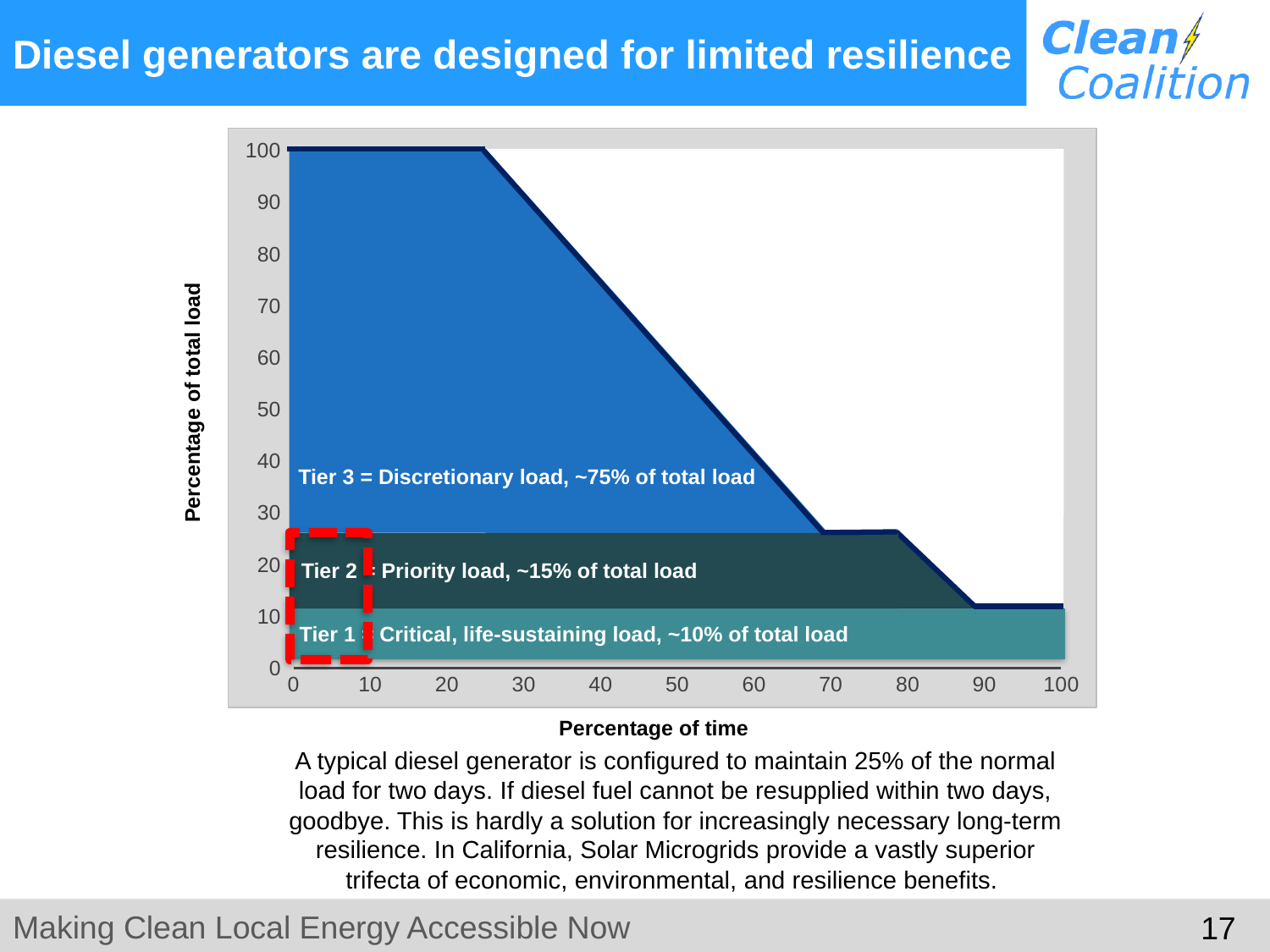
What is the title of the x axis? Percentage of time Is the percentage of total load at 75 percent of time greater or less than 20? greater Is the percentage of total load at 50 percent of time greater or less than 50? greater Is the percentage of total load at 10 percent of time greater or less than 90? greater Does the percentage of total load rise or fall as percentage of time increases? fall Which is larger, the percentage of total load at 20 percent of time or at 60 percent of time? 20 percent of time What kind of chart is shown on the slide? area chart What is the title of the y axis? Percentage of total load What is the percentage of total load at 0 percent of time? 100 What is the highest value shown on the y axis? 100 How many load tiers are labelled on the chart? 3